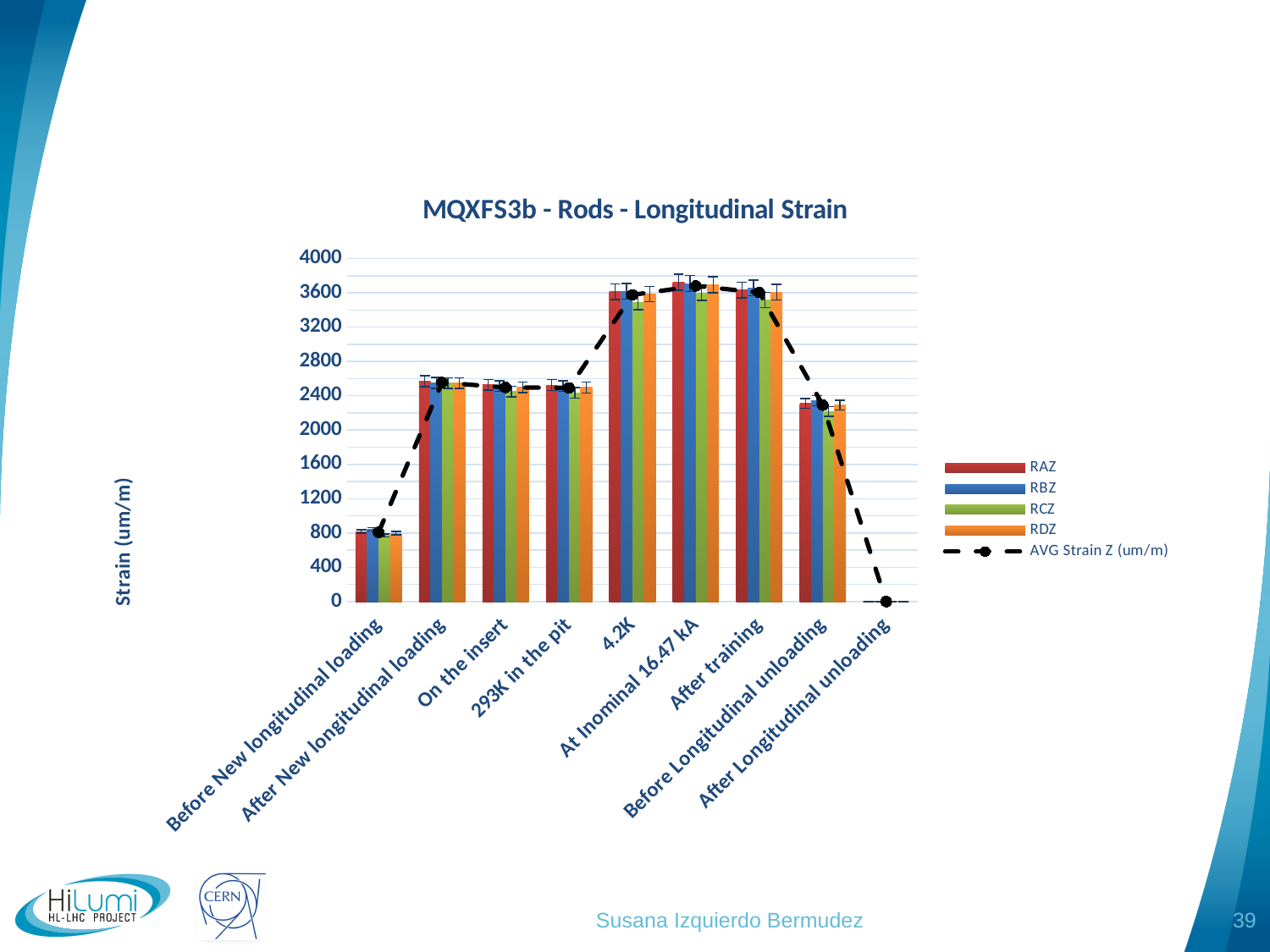
What is the value of AVG Strain Z (um/m) at 'After Longitudinal unloading'? 0 Is the RAZ value for '4.2K' greater or less than 3200? greater Does the AVG Strain Z (um/m) line rise or fall from 'After training' to 'After Longitudinal unloading'? Fall What is the title of the chart? MQXFS3b - Rods - Longitudinal Strain Is the RAZ value for 'Before Longitudinal unloading' greater or less than 2400? less How many categories are shown along the x axis? 9 Which is larger, the RAZ value for '4.2K' or for 'Before New longitudinal loading'? 4.2K Which category has the lowest AVG Strain Z (um/m) value? After Longitudinal unloading How many entries does the chart legend list? 5 What type of chart is shown on the slide? Combination bar and line chart Is the RAZ value for 'After New longitudinal loading' greater or less than 2400? greater What is the label of the vertical axis? Strain (um/m)